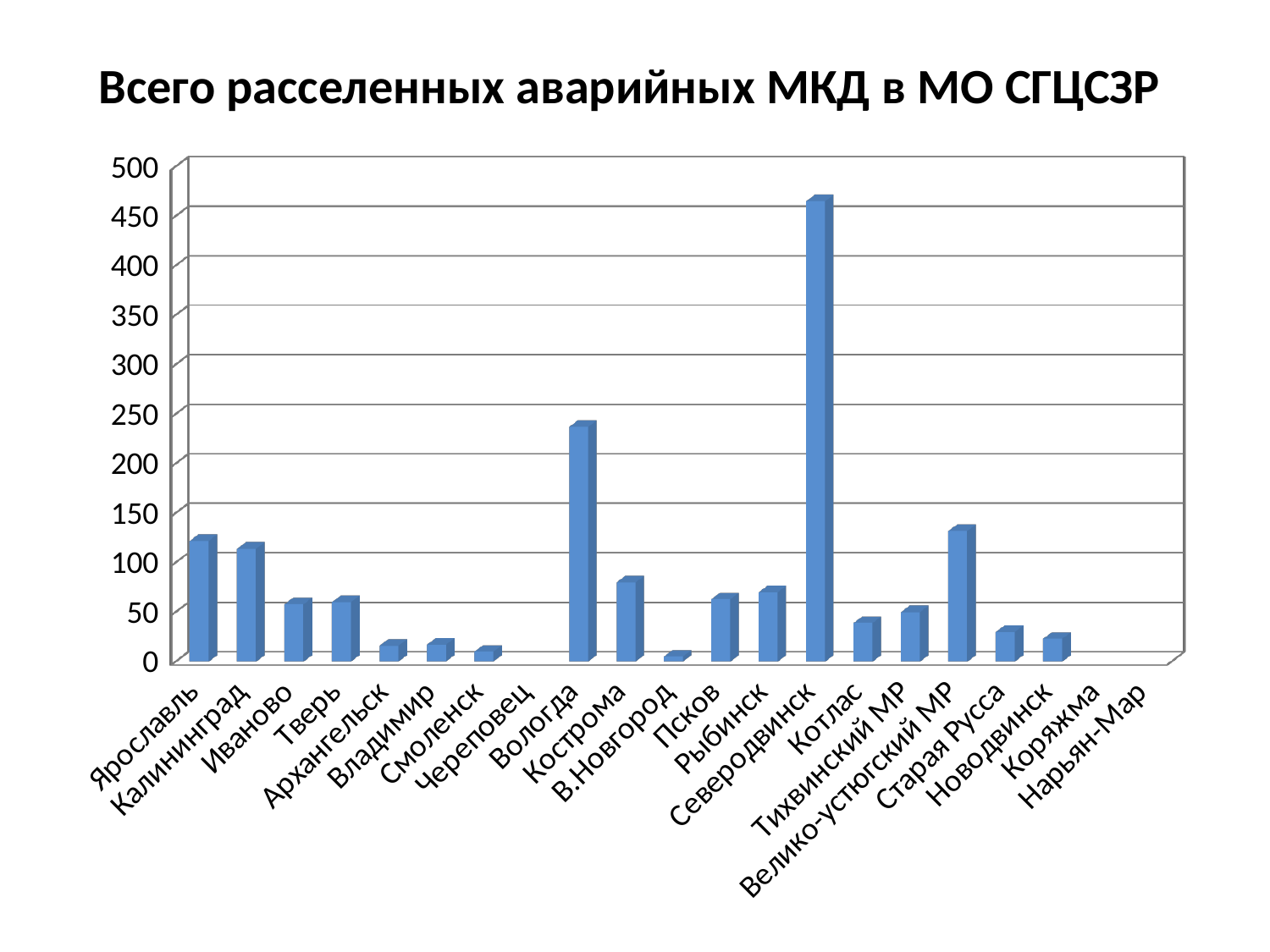
Which city or district has the highest number of resettled emergency apartment buildings? Северодвинск How many categories are shown on the x axis of the chart? 21 Is the value for Вологда greater or less than 200? greater Is the value for Архангельск greater or less than 50? less Which has a larger value, Вологда or Кострома? Вологда Is the value for Велико-устюгский МР greater or less than 100? greater What is the title of the chart? Всего расселенных аварийных МКД в МО СГЦСЗР Which has a larger value, Велико-устюгский МР or Котлас? Велико-устюгский МР What kind of chart is shown on the slide? bar chart